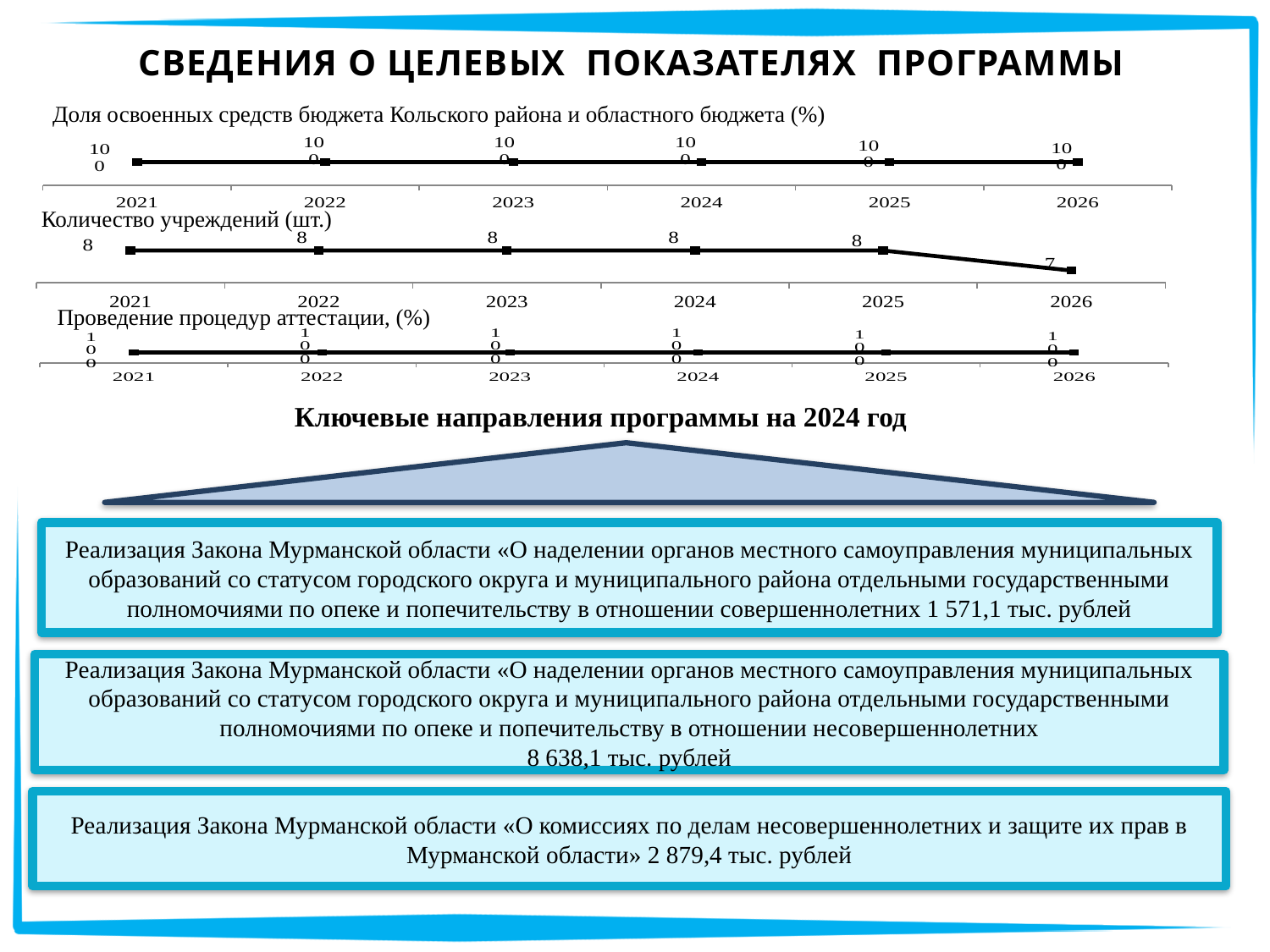
How many years are plotted in the chart 'Количество учреждений (шт.)'? 6 In the chart 'Количество учреждений (шт.)', what is the value for 2021? 8 In the chart 'Доля освоенных средств бюджета Кольского района и областного бюджета (%)', what is the value for 2023? 100 In the chart 'Количество учреждений (шт.)', what is the value for 2026? 7 In the chart 'Количество учреждений (шт.)', what is the difference between the values for 2025 and 2026? 1 In the chart 'Доля освоенных средств бюджета Кольского района и областного бюджета (%)', do the values rise, fall or stay flat from 2021 to 2026? stay flat What kind of chart is 'Количество учреждений (шт.)'? line chart In the chart 'Количество учреждений (шт.)', which is larger: the value for 2024 or the value for 2026? 2024 How many charts are shown on the slide? 3 In the chart 'Количество учреждений (шт.)', which year has the lowest value? 2026 In the chart 'Количество учреждений (шт.)', do the values rise, fall or stay flat from 2025 to 2026? fall In the chart 'Проведение процедур аттестации, (%)', what is the value for 2026? 100